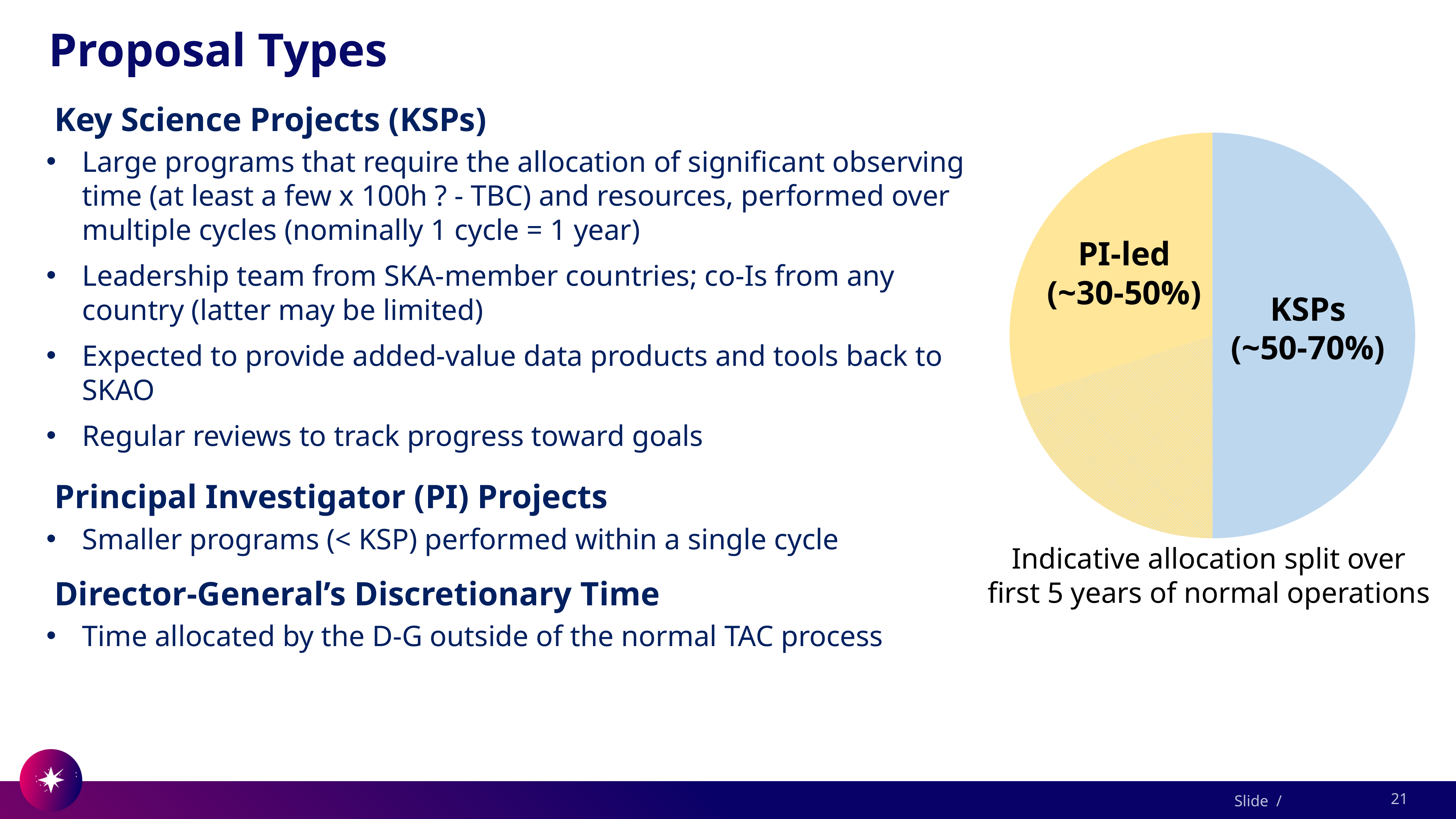
What allocation range is printed on the PI-led slice of the pie chart? ~30-50% What colour is the KSPs slice in the pie chart? light blue In the pie chart, which slice is larger: KSPs or PI-led? KSPs Which slice of the pie chart is the largest? KSPs What kind of chart is shown on the right of the slide? pie chart What allocation range is printed on the KSPs slice of the pie chart? ~50-70% How many slices does the pie chart have? 3 What caption is written below the pie chart? Indicative allocation split over first 5 years of normal operations